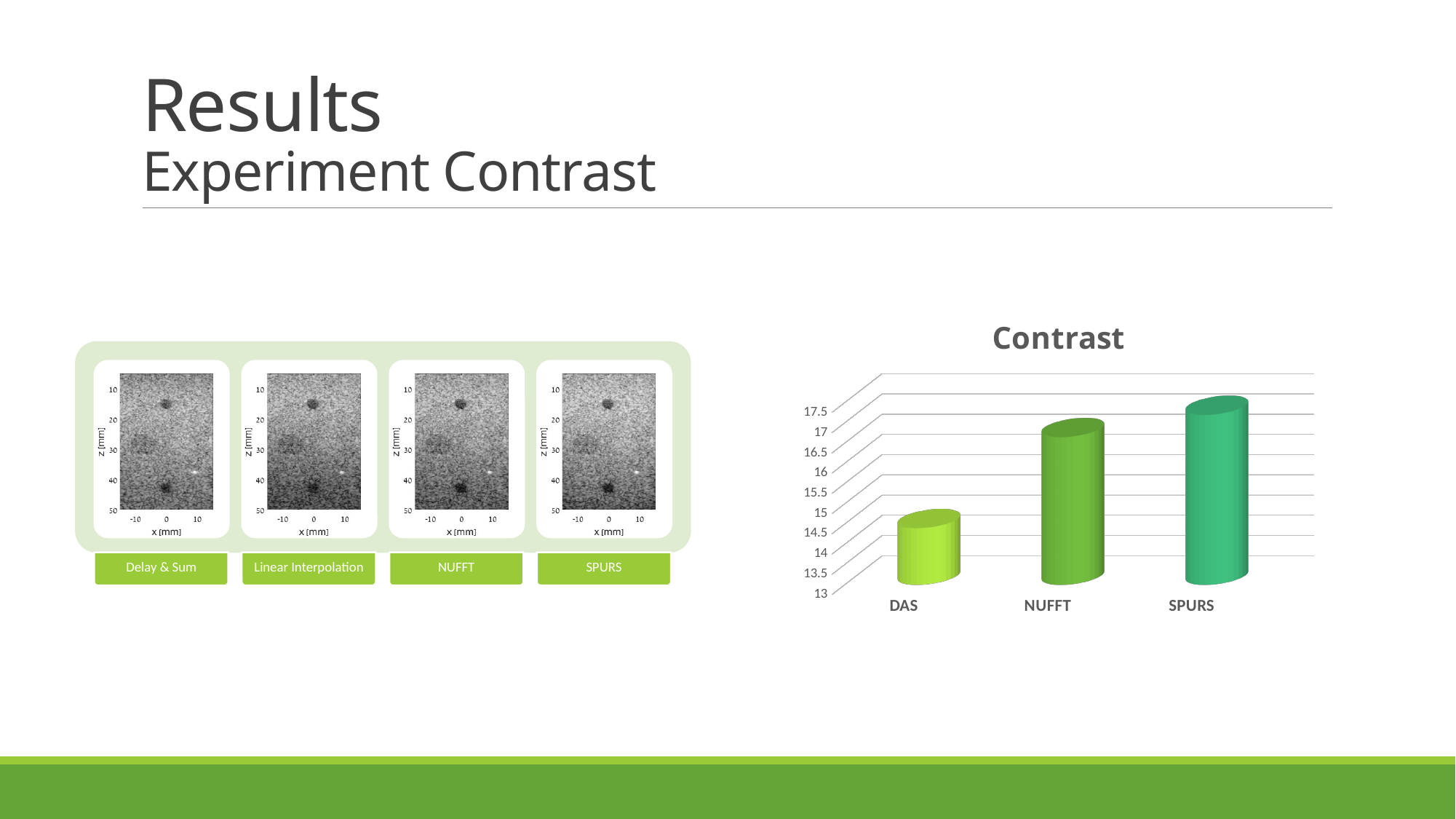
Is the contrast value for NUFFT greater or less than 15? greater Do the contrast values rise or fall from DAS to SPURS along the x axis? rise Which has a larger contrast value, DAS or NUFFT? NUFFT Is the contrast value for DAS greater or less than 16? less What kind of chart is shown on the slide? bar chart What is the title of the chart? Contrast Which category has the lowest contrast value? DAS Which category has the highest contrast value? SPURS What is the lowest value shown on the vertical axis of the Contrast chart? 13 How many categories are plotted in the Contrast chart? 3 Is the contrast value for SPURS greater or less than 16? greater